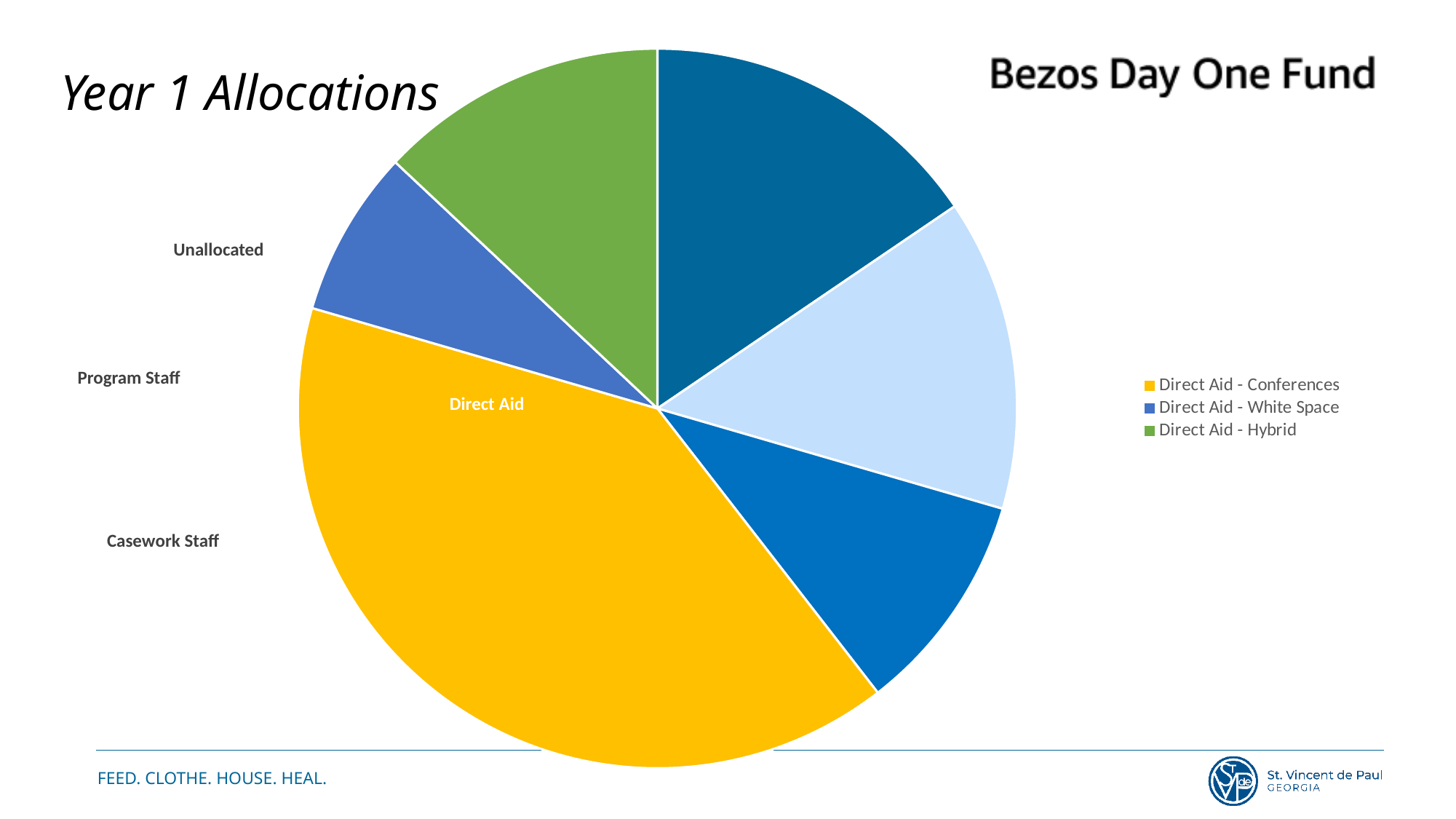
How many entries does the legend list? 3 What kind of chart is shown on the slide? pie chart What is the title of the chart on the left of the slide? Year 1 Allocations Which is larger, the Direct Aid slice or the green slice? Direct Aid What colour is the slice labelled Direct Aid? yellow How many slices does the pie chart have? 6 Which slice of the pie chart is the largest? Direct Aid